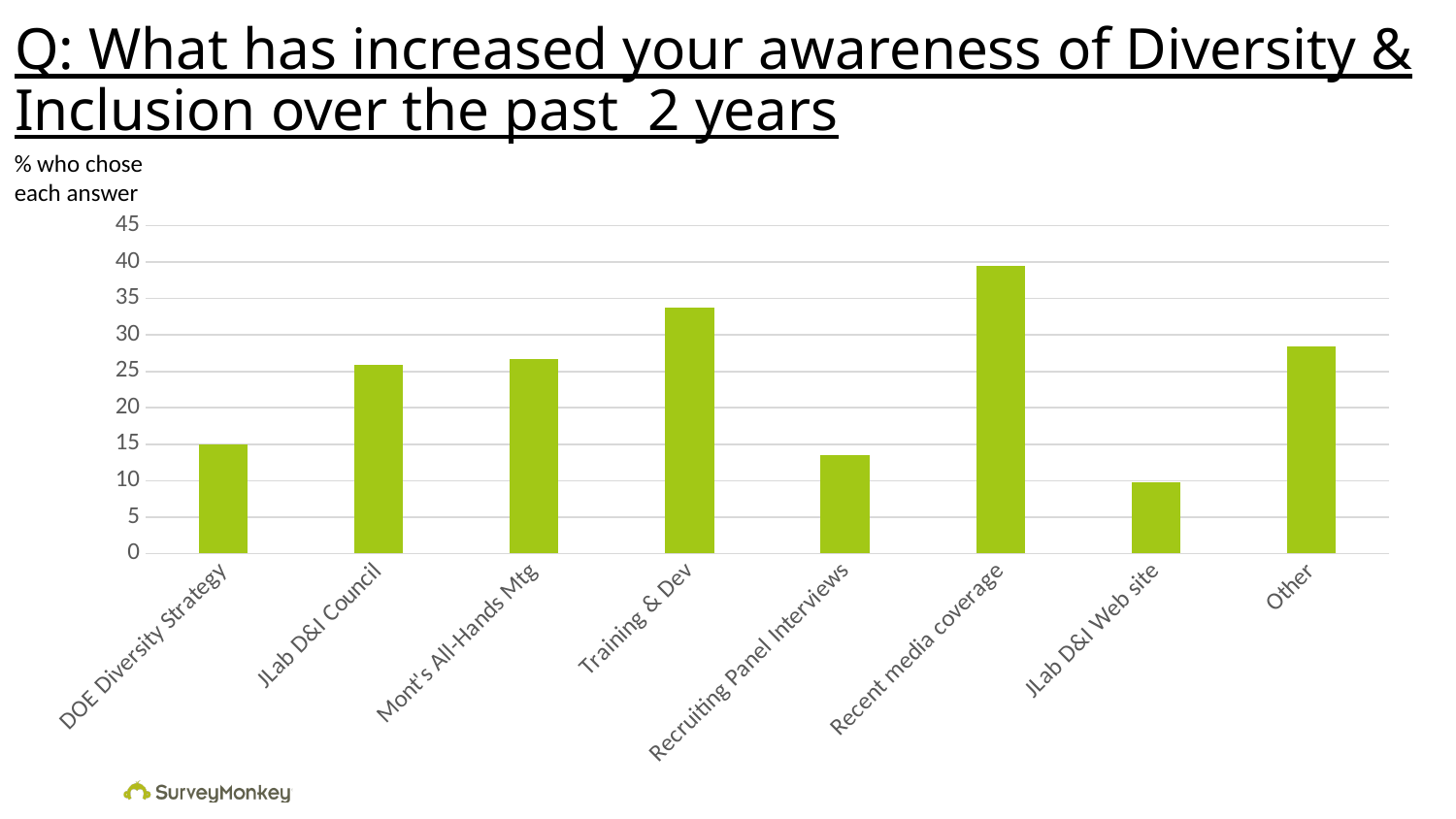
Is the value for Recent media coverage greater or less than 35? greater Is the value for Recruiting Panel Interviews greater or less than 15? less Which has a higher value, DOE Diversity Strategy or Recruiting Panel Interviews? DOE Diversity Strategy What does the label above the y axis say the values represent? % who chose each answer What kind of chart is shown on the slide? bar chart Which category has the lowest value in the chart? JLab D&I Web site How many answer categories are shown on the x axis of the chart? 8 Which has a higher value, Training & Dev or Other? Training & Dev Is the value for Training & Dev greater or less than 30? greater Which category has the highest value in the chart? Recent media coverage